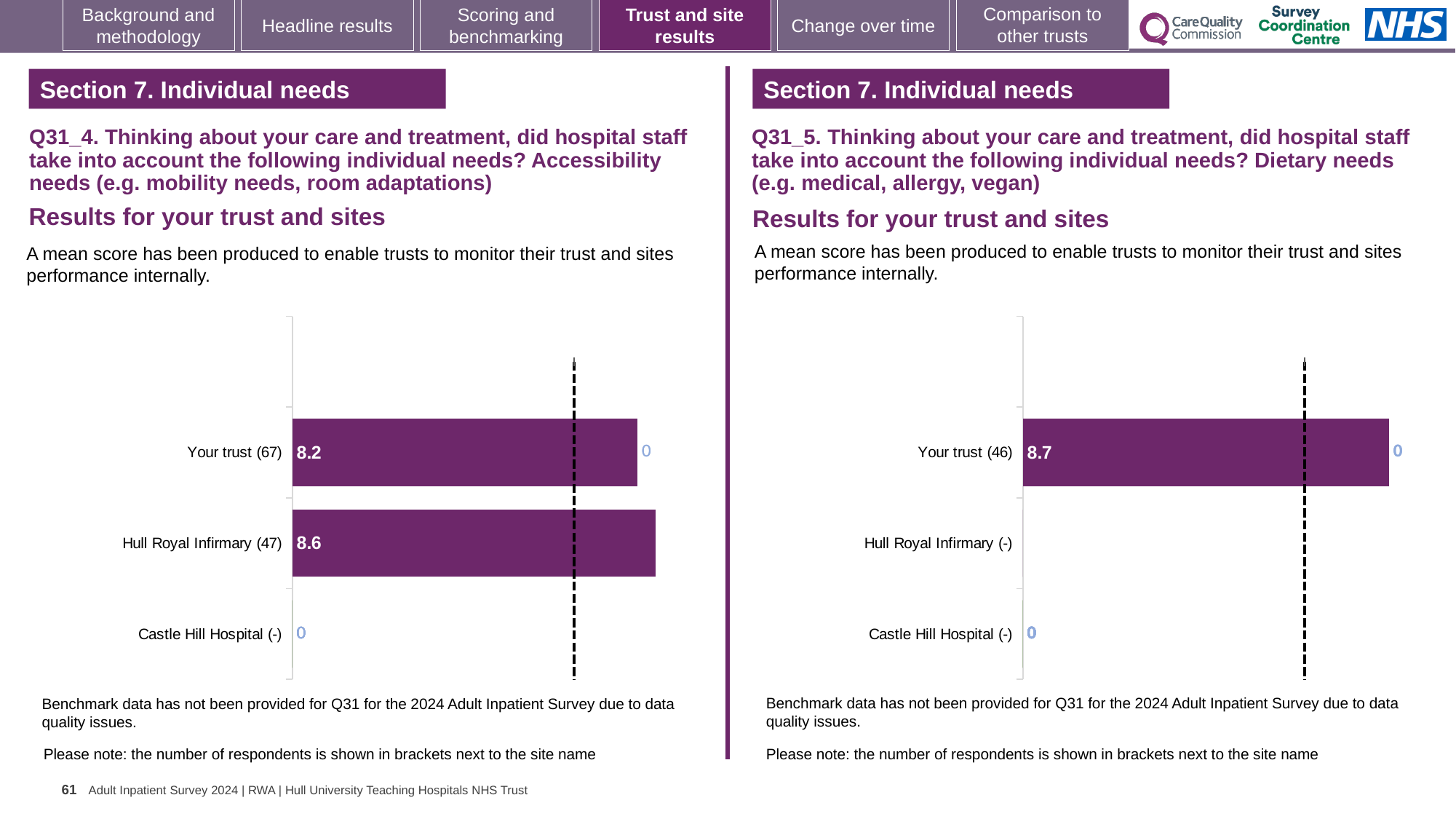
In the Q31_4 chart on the left, what is the mean score for Your trust? 8.2 What type of chart is used in the Q31_4 chart on the left? Bar chart In the Q31_5 chart on the right, what is the mean score for Your trust? 8.7 In the Q31_4 chart on the left, what is the mean score for Hull Royal Infirmary? 8.6 Is the Your trust score in the Q31_5 chart on the right greater or less than the Your trust score in the Q31_4 chart on the left? greater In the Q31_4 chart on the left, how many respondents are shown in brackets for Your trust? 67 In the Q31_4 chart on the left, which site has the higher mean score, Your trust or Hull Royal Infirmary? Hull Royal Infirmary In the Q31_5 chart on the right, how many respondents are shown in brackets for Your trust? 46 In the Q31_4 chart on the left, which category has the highest mean score? Hull Royal Infirmary In the Q31_4 chart on the left, what is the difference between the Hull Royal Infirmary score and the Your trust score? 0.4 How many categories are listed on the y axis of the Q31_5 chart on the right? 3